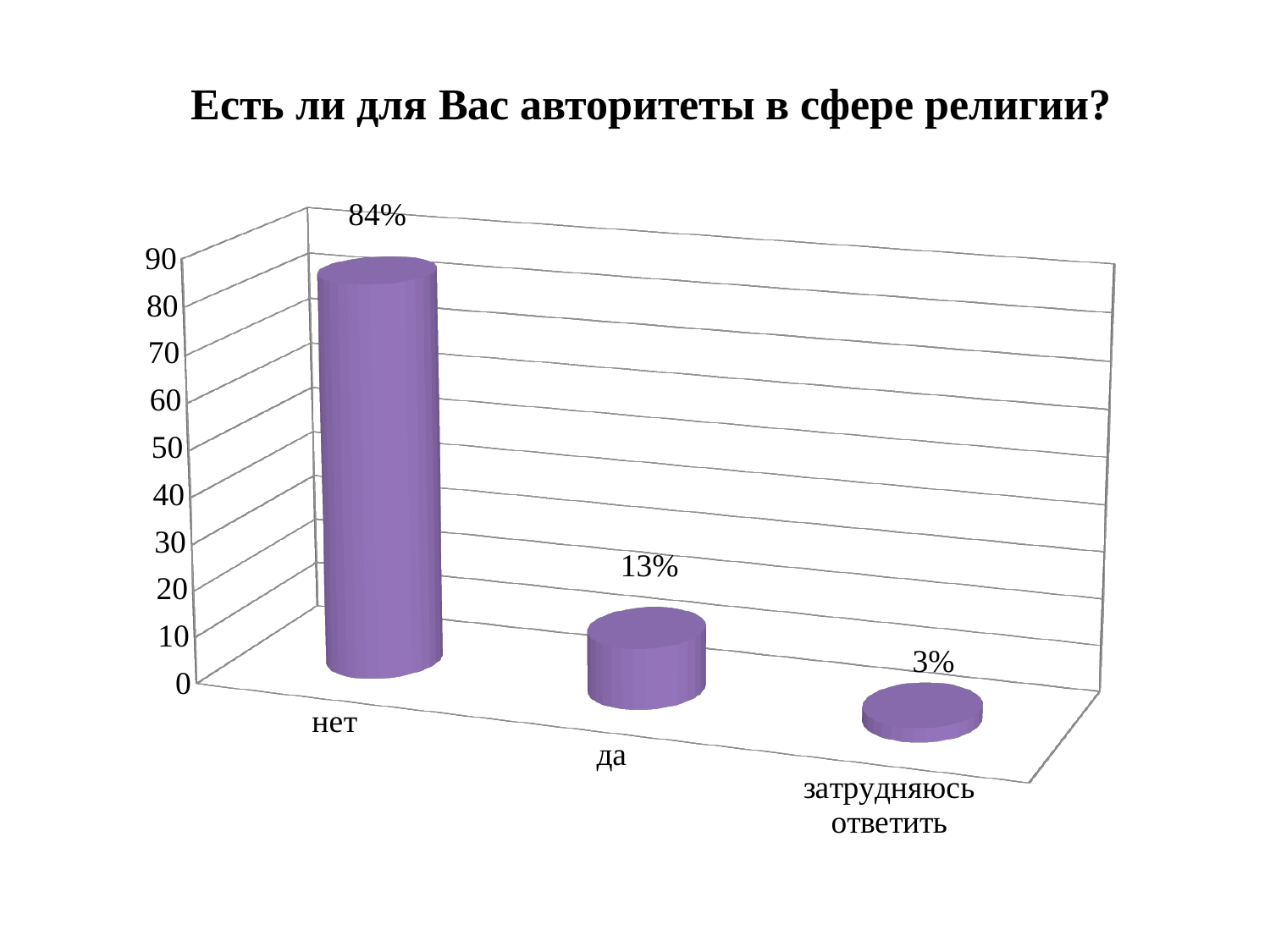
Which is larger, the value for "да" or the value for "затрудняюсь ответить"? да What is the title of the chart? Есть ли для Вас авторитеты в сфере религии? What is the difference between the values for "да" and "затрудняюсь ответить"? 10% What kind of chart is shown on the slide? bar chart Which category has the lowest value? затрудняюсь ответить What is the value for "да"? 13% Is the value for "нет" greater or less than 50? greater What is the difference between the values for "нет" and "да"? 71% How many categories are shown in the chart? 3 What is the value for "затрудняюсь ответить"? 3% Which category has the highest value? нет What is the value for "нет"? 84%